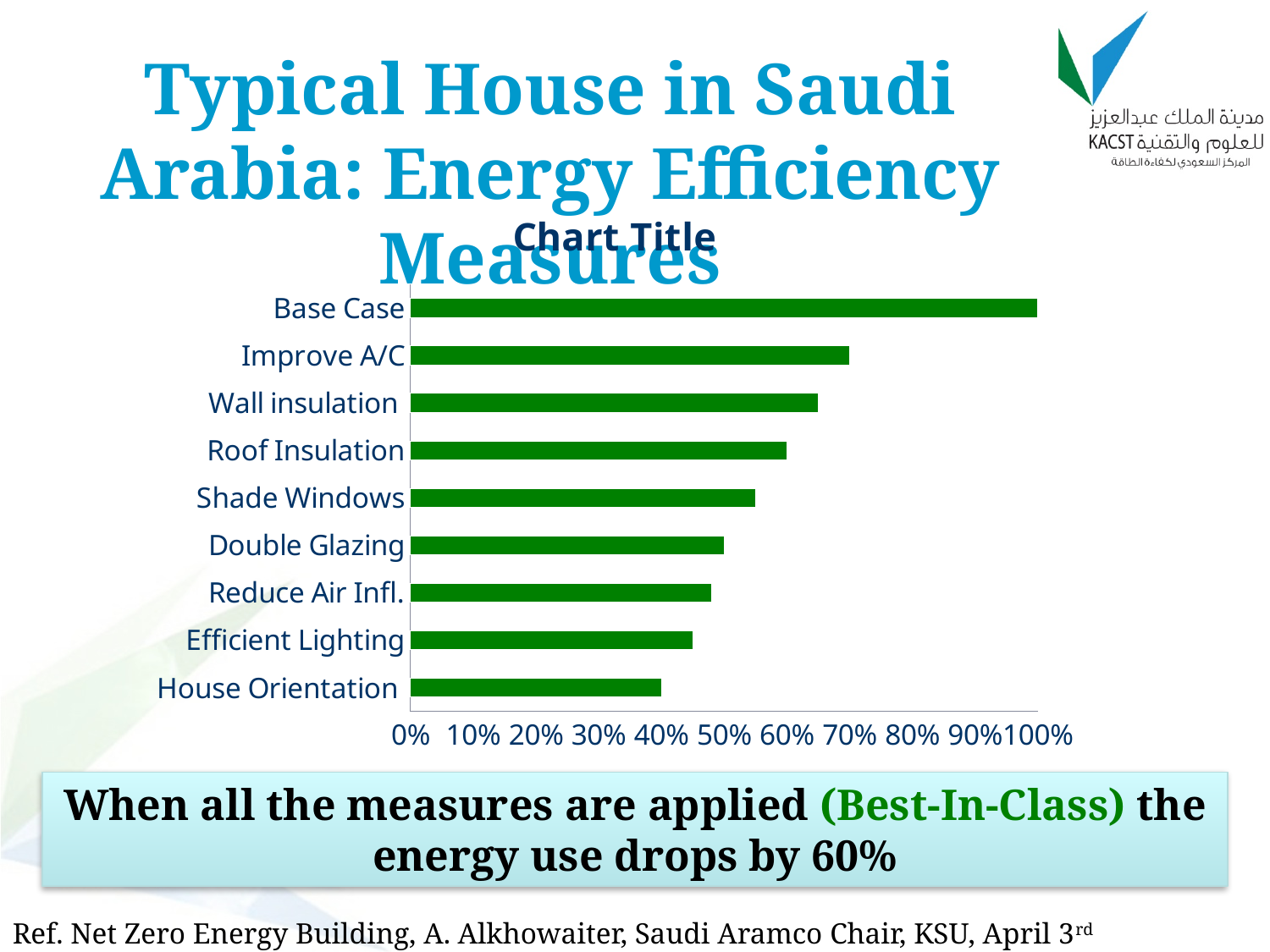
Is the value for Wall insulation greater or less than 60%? greater Is the value for Efficient Lighting greater or less than 50%? less Is the value for Shade Windows greater or less than 50%? greater How many categories are plotted in the chart? 9 Which category has the highest value in the chart? Base Case Which category has the lowest value in the chart? House Orientation What type of chart is shown on the slide? bar chart Do the bar values increase or decrease going from the top category to the bottom category? decrease Which is larger, the value for Improve A/C or the value for Wall insulation? Improve A/C What is the title shown above the chart? Chart Title What is the value for Base Case? 100%